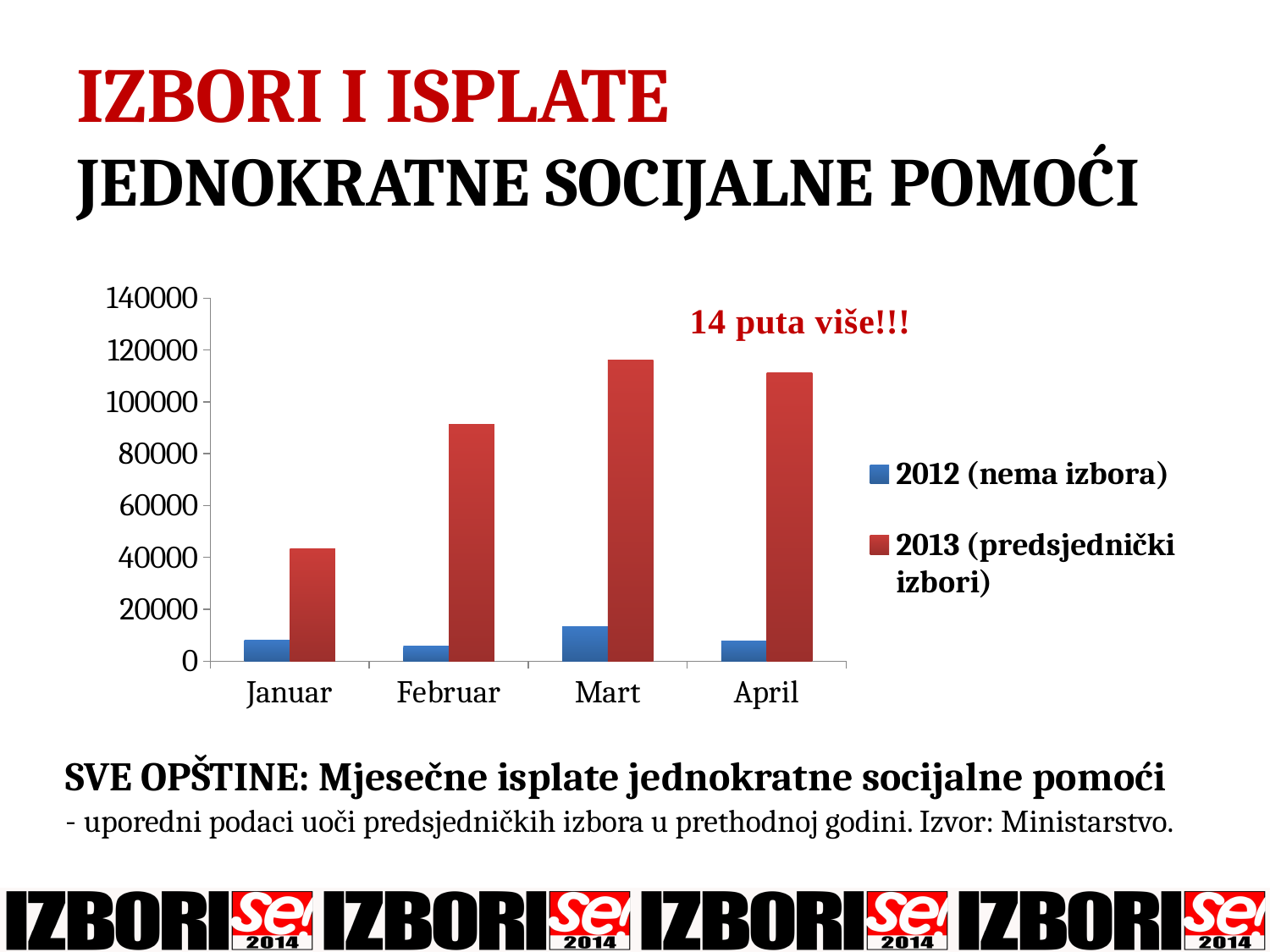
Is the 2013 (predsjednički izbori) value for Mart greater or less than 100000? greater Which month has the highest value for the 2013 (predsjednički izbori) series? Mart How many series does the chart legend list? 2 Is the 2013 (predsjednički izbori) value for Februar greater or less than 80000? greater Which month has the highest value for the 2012 (nema izbora) series? Mart Which is larger: the 2013 (predsjednički izbori) value for Januar or for Februar? Februar What kind of chart is shown on the slide? bar chart What annotation text is printed in red above the bars in the chart? 14 puta više!!! How many months are shown on the x axis of the chart? 4 Is the 2012 (nema izbora) value for Mart greater or less than 20000? less Do the 2013 (predsjednički izbori) values rise or fall from Januar to Mart? rise Which month has the lowest value for the 2013 (predsjednički izbori) series? Januar